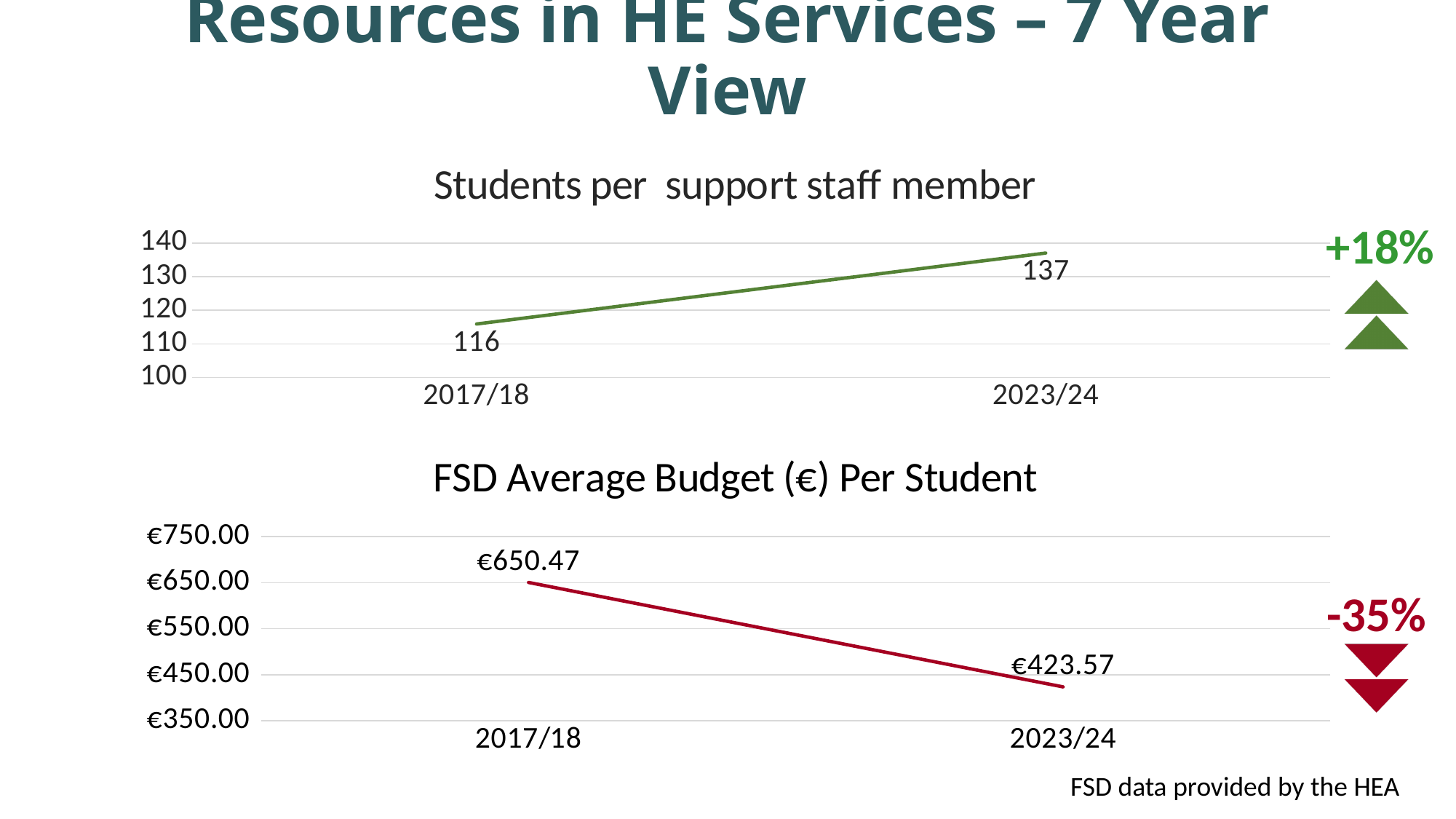
In the 'Students per support staff member' chart, what is the value for 2017/18? 116 In the 'Students per support staff member' chart, how many data points are plotted? 2 In the 'FSD Average Budget (€) Per Student' chart, is the value for 2023/24 greater or less than €450.00? less In the 'FSD Average Budget (€) Per Student' chart, what is the value for 2023/24? €423.57 In the 'Students per support staff member' chart, what is the value for 2023/24? 137 What kind of chart is the 'Students per support staff member' chart? line chart In the 'Students per support staff member' chart, do the values rise or fall from 2017/18 to 2023/24? rise In the 'FSD Average Budget (€) Per Student' chart, what is the value for 2017/18? €650.47 What percentage change is shown next to the 'FSD Average Budget (€) Per Student' chart? -35% In the 'Students per support staff member' chart, what is the difference between the 2023/24 and 2017/18 values? 21 In the 'FSD Average Budget (€) Per Student' chart, which year has the lower value? 2023/24 In the 'FSD Average Budget (€) Per Student' chart, do the values rise or fall from 2017/18 to 2023/24? fall